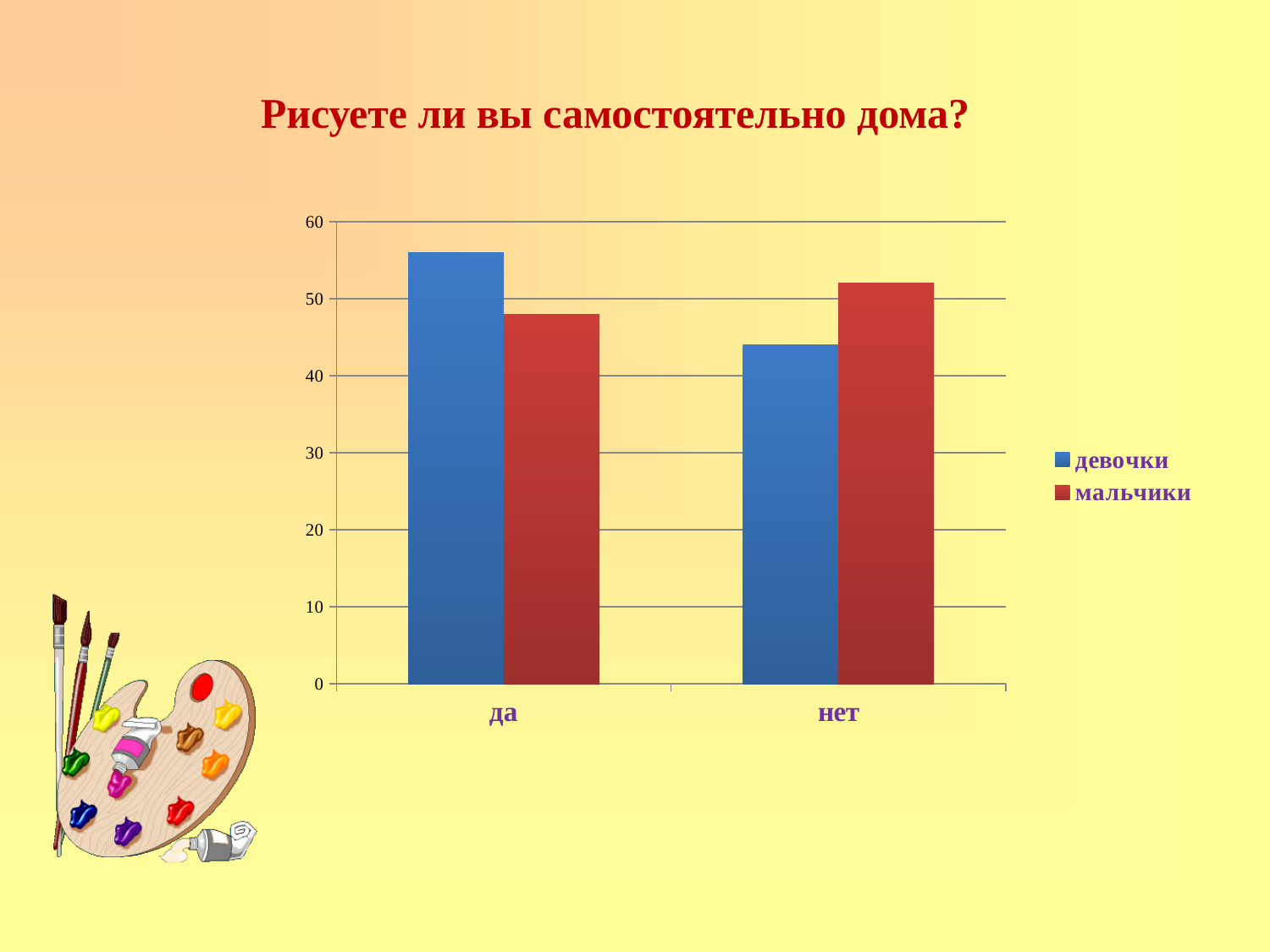
In the category нет, which series has the larger value, девочки or мальчики? мальчики What is the title of the chart? Рисуете ли вы самостоятельно дома? Which series is shown in blue? девочки How many categories are shown on the x axis? 2 Is the value for девочки in the category нет greater or less than 50? less For the series девочки, which category has the higher value, да or нет? да Is the value for мальчики in the category да greater or less than 50? less Is the value for мальчики in the category нет greater or less than 40? greater In the category да, which series has the larger value, девочки or мальчики? девочки How many series does the legend list? 2 What type of chart is shown on the slide? bar chart